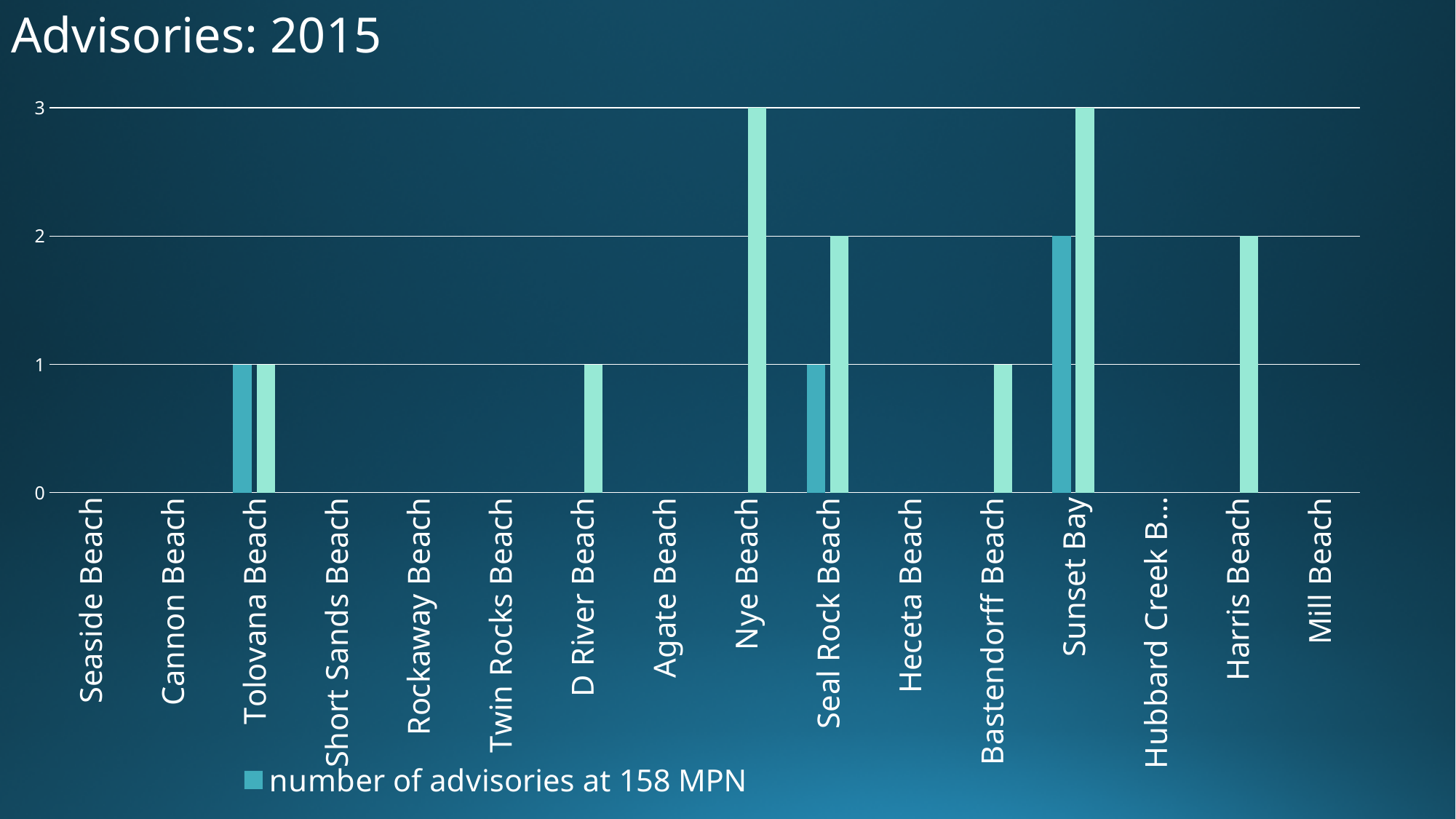
Which has more advisories at 158 MPN, Sunset Bay or Seal Rock Beach? Sunset Bay What is the number of advisories at 158 MPN for Tolovana Beach? 1 How many series does the legend list? 1 Is the number of advisories at 158 MPN for Sunset Bay greater or less than 1? greater What is the difference between the number of advisories at 158 MPN for Sunset Bay and for Tolovana Beach? 1 What kind of chart is shown on the slide? bar chart What is the number of advisories at 158 MPN for Seal Rock Beach? 1 What is the title of the chart? Advisories: 2015 How many beaches are listed along the x axis? 16 What is the number of advisories at 158 MPN for Sunset Bay? 2 Which beach has the highest number of advisories at 158 MPN? Sunset Bay What is the legend entry shown below the chart? number of advisories at 158 MPN